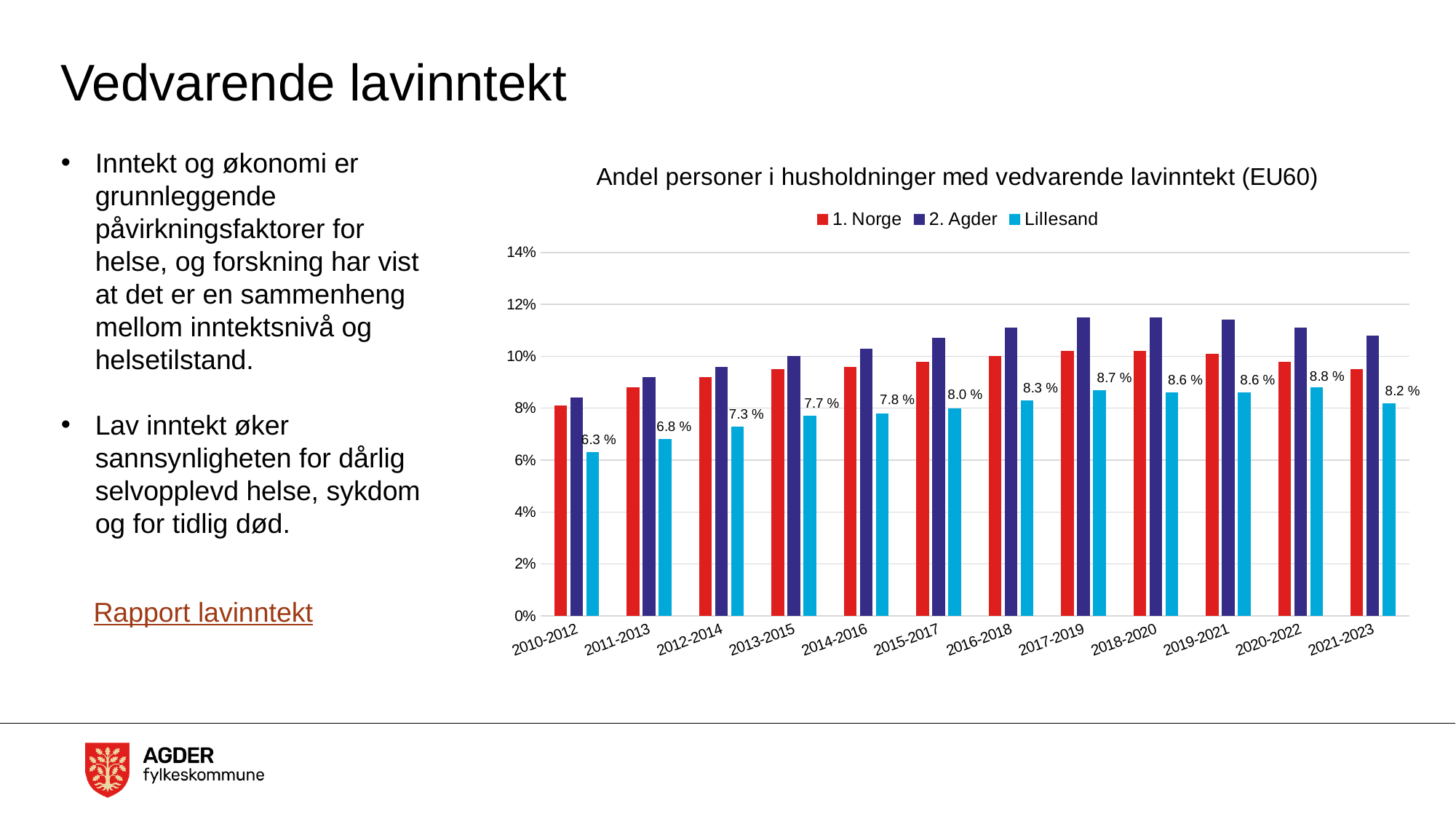
How many periods are shown on the x axis? 12 In which period is the Lillesand value highest? 2020-2022 How many series does the legend list? 3 What is the value for Lillesand in 2021-2023? 8.2 % What is the value for Lillesand in 2010-2012? 6.3 % Which is larger in 2017-2019: the value for 2. Agder or the value for Lillesand? 2. Agder What is the difference between the Lillesand values for 2020-2022 and 2010-2012? 2.5 percentage points Is the value for 1. Norge in 2010-2012 greater or less than 10%? less What is the value for Lillesand in 2020-2022? 8.8 % Is the value for 2. Agder in 2018-2020 greater or less than 10%? greater In which period is the Lillesand value lowest? 2010-2012 What kind of chart is shown on the slide? Bar chart